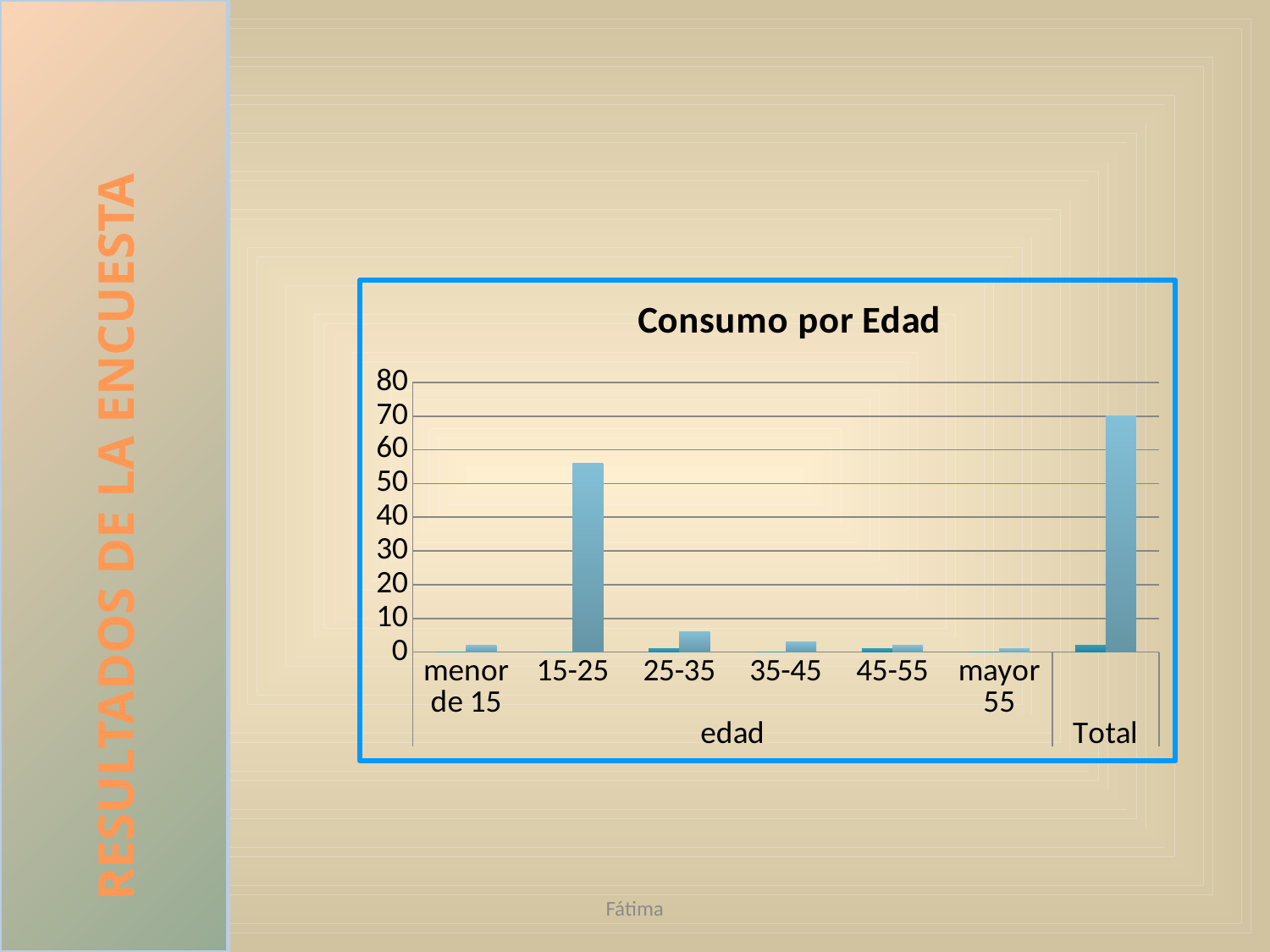
Is the taller bar for 25-35 greater or less than 10? less Is the taller bar for 15-25 greater or less than 60? less What kind of chart is shown on the slide? bar chart What is the label of the horizontal axis group containing the age ranges? edad Which is larger, the taller bar for 25-35 or the taller bar for mayor 55? 25-35 Is the taller bar for Total greater or less than 60? greater Which is larger, the taller bar for 15-25 or the taller bar for Total? Total What is the title of the chart? Consumo por Edad What is the highest value shown on the vertical axis? 80 How many age-group categories are shown under the 'edad' axis label? 6 Which age group has the highest bar in the chart? 15-25